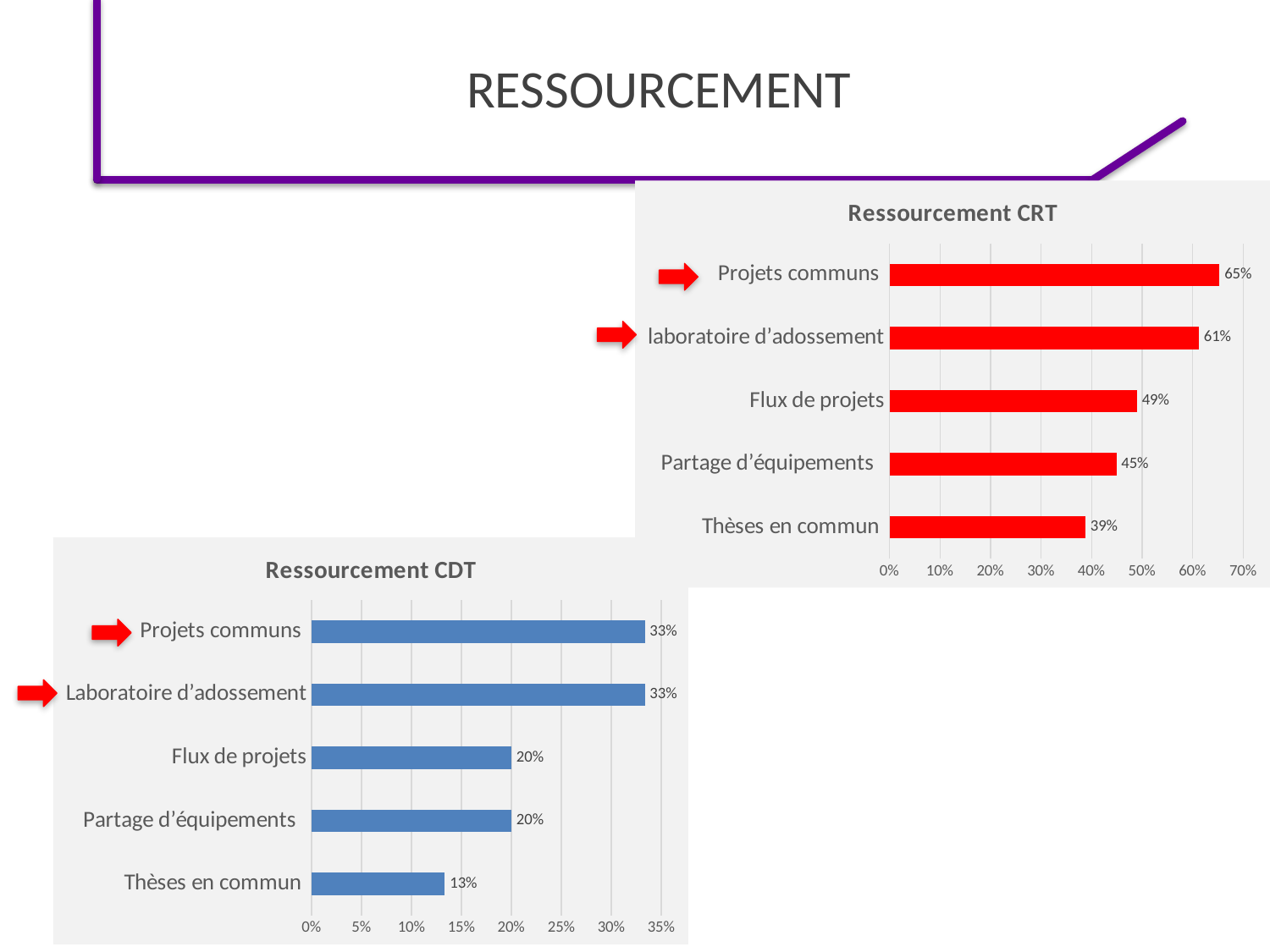
In the 'Ressourcement CRT' chart, which category has the highest value? Projets communs In the 'Ressourcement CRT' chart, what is the value for Projets communs? 65% In the 'Ressourcement CDT' chart, which category has the lowest value? Thèses en commun In the 'Ressourcement CRT' chart, is the value for laboratoire d'adossement greater or less than 50%? greater In the 'Ressourcement CDT' chart, what is the difference between Projets communs and Thèses en commun? 20% What kind of chart is 'Ressourcement CRT'? Bar chart What colour are the bars in the 'Ressourcement CDT' chart? Blue In the 'Ressourcement CDT' chart, what is the value for Flux de projets? 20% In the 'Ressourcement CRT' chart, what is the value for Thèses en commun? 39% In the 'Ressourcement CRT' chart, what is the difference between Projets communs and Thèses en commun? 26% How many categories are shown in the 'Ressourcement CDT' chart? 5 In the 'Ressourcement CRT' chart, which is larger: Flux de projets or Partage d'équipements? Flux de projets